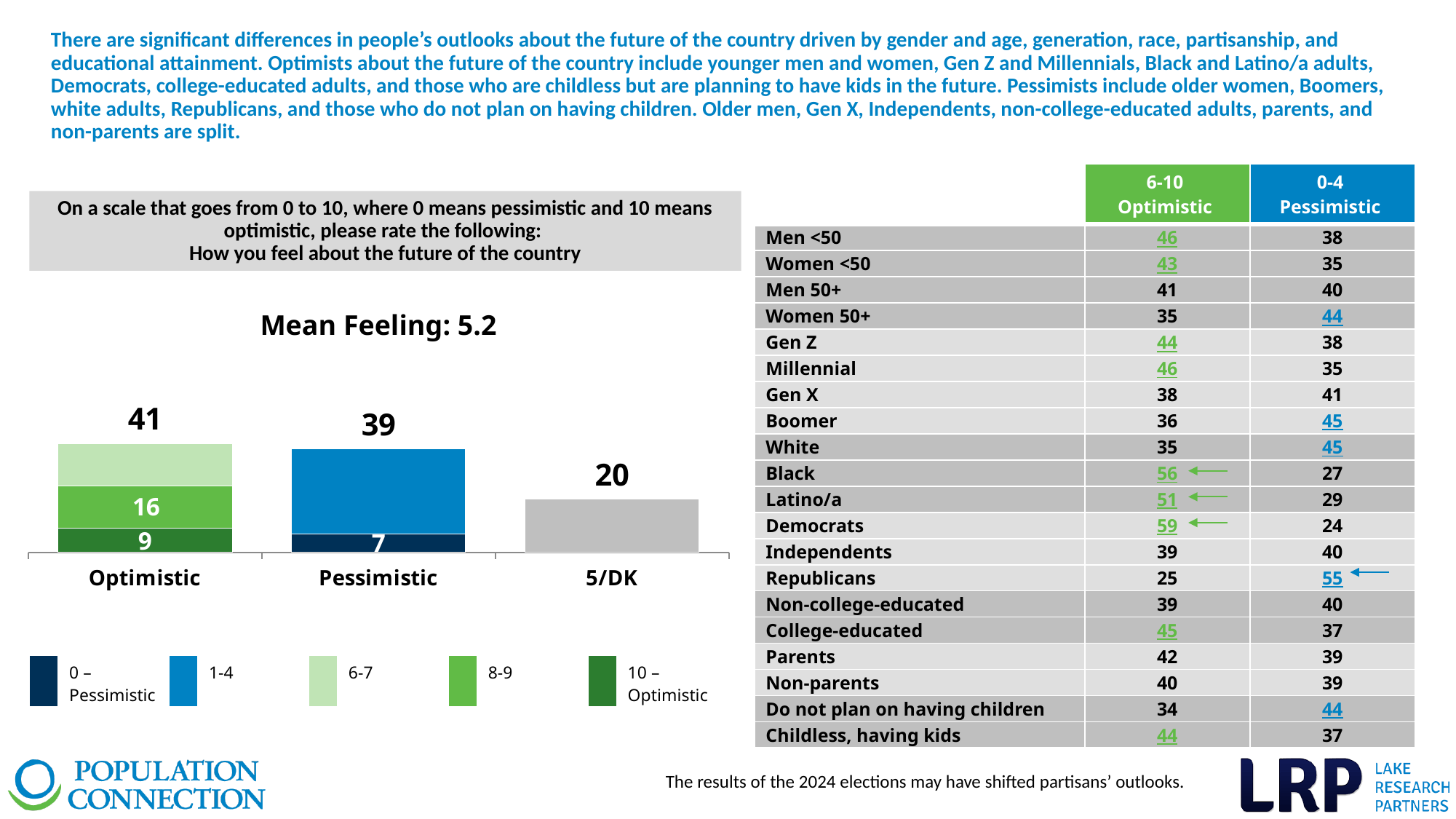
How many categories are shown on the x axis of the chart? 3 What is the value of the 8-9 segment in the Optimistic bar? 16 Which is larger, the Pessimistic total or the 5/DK value? Pessimistic Which category has the highest total value? Optimistic How many entries does the chart legend list? 5 What is the total value shown for the Optimistic bar? 41 Which category has the lowest value? 5/DK What is the total value shown for the Pessimistic bar? 39 What kind of chart is shown on the slide? bar chart What is the difference between the Optimistic total and the Pessimistic total? 2 What is the value of the 0 – Pessimistic segment in the Pessimistic bar? 7 What is the value for 5/DK? 20